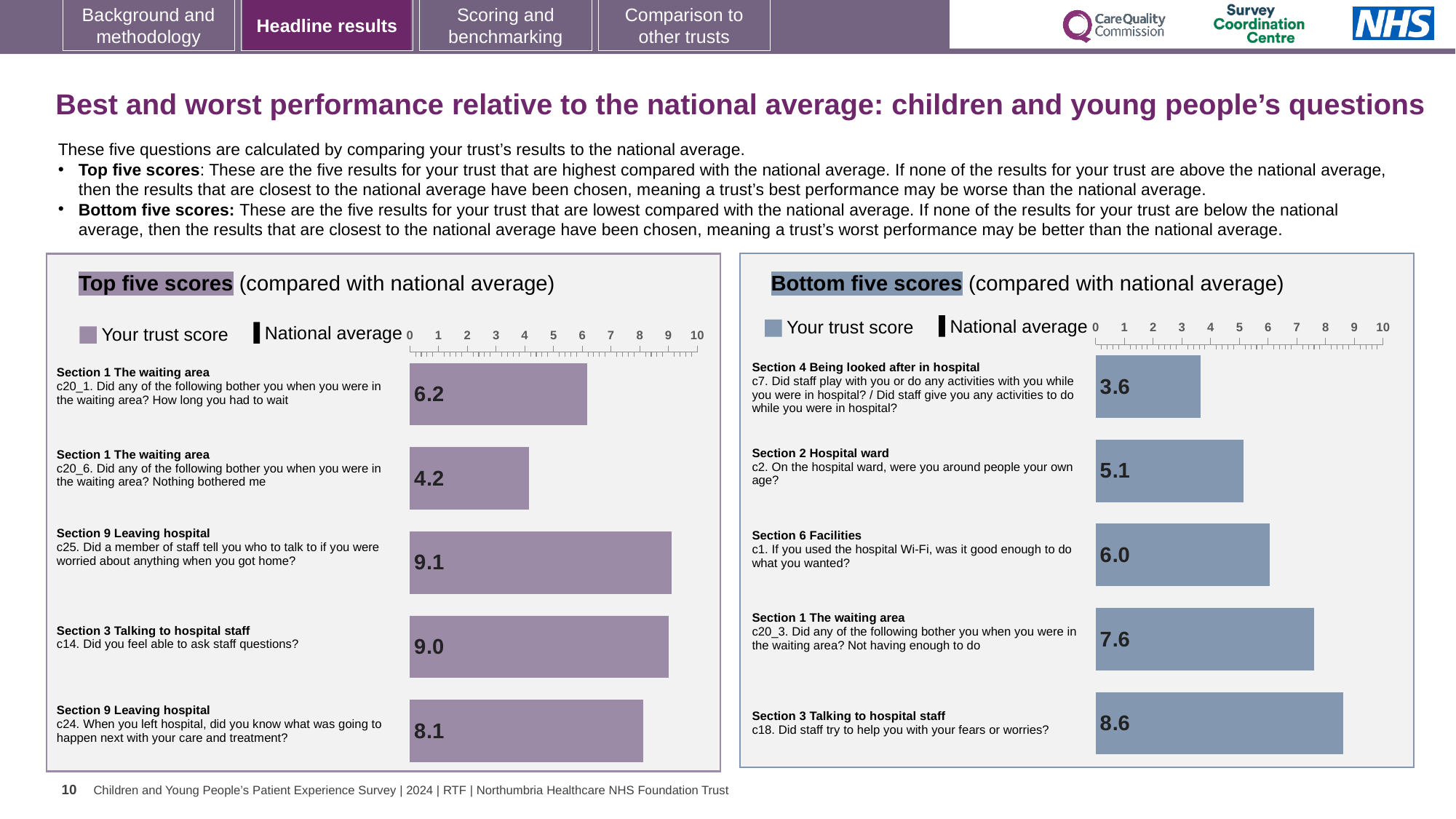
In the 'Top five scores' chart, what is the difference between the trust scores for c25 and c20_6? 4.9 In the 'Top five scores' chart, which question has the highest trust score? c25. Did a member of staff tell you who to talk to if you were worried about anything when you got home? How many questions are plotted in the 'Top five scores' chart? 5 In the 'Bottom five scores' chart, what is the difference between the trust scores for c18 and c7? 5.0 How many entries does the legend of the 'Top five scores' chart list? 2 In the 'Bottom five scores' chart, what is the trust score for c18 (Did staff try to help you with your fears or worries?)? 8.6 What type of chart is the 'Bottom five scores' chart? Bar chart In the 'Bottom five scores' chart, which question has the lowest trust score? c7. Did staff play with you or do any activities with you while you were in hospital? In the 'Top five scores' chart, what is the trust score for c25 (Did a member of staff tell you who to talk to if you were worried about anything when you got home?)? 9.1 In the 'Top five scores' chart, what is the trust score for c20_6 (Nothing bothered me in the waiting area)? 4.2 In the 'Bottom five scores' chart, what is the trust score for c7 (Did staff play with you or do any activities with you while you were in hospital?)? 3.6 In the 'Bottom five scores' chart, which has the larger trust score: c2 (On the hospital ward, were you around people your own age?) or c20_3 (Not having enough to do in the waiting area)? c20_3